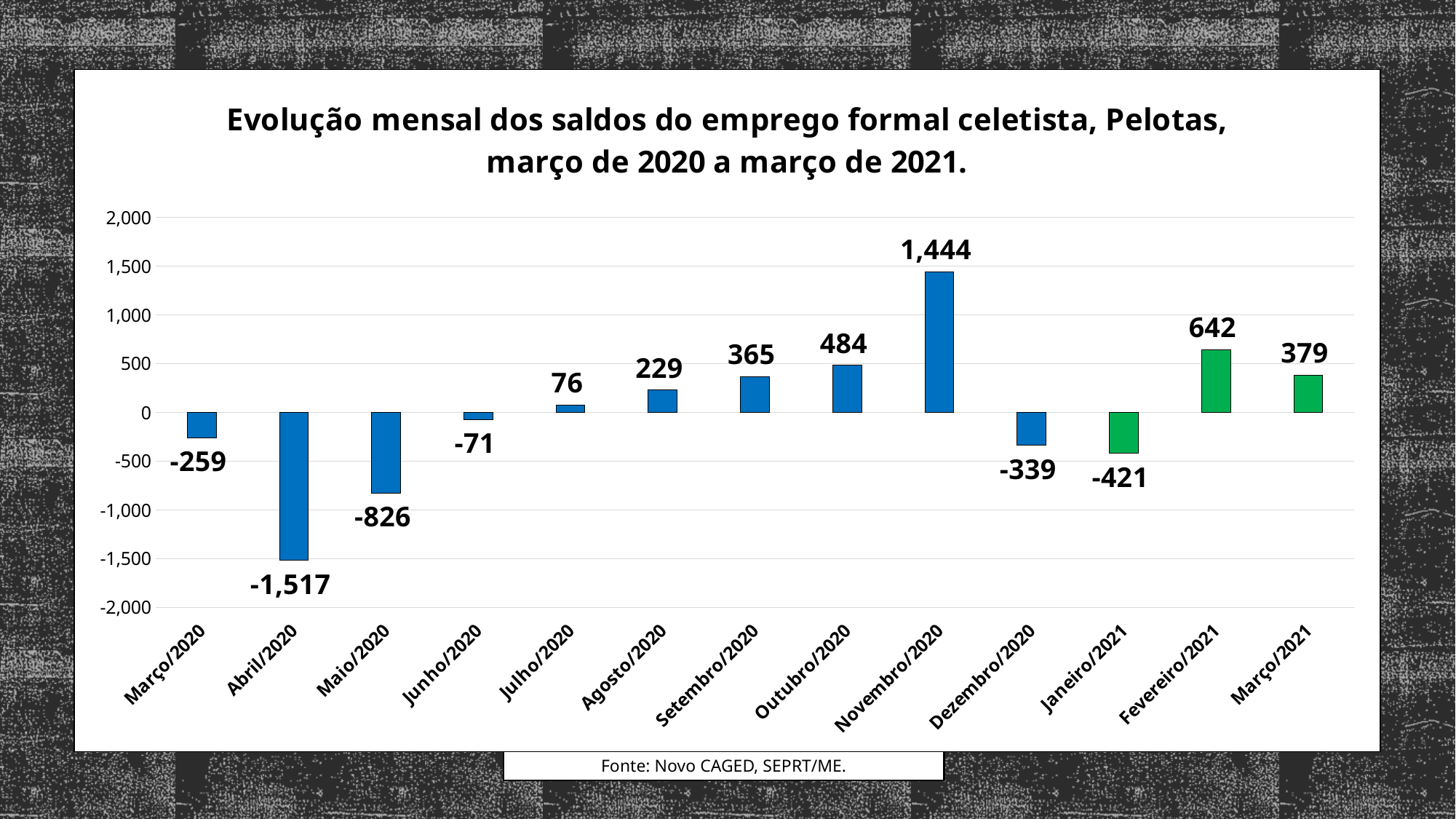
Do the values rise or fall from Julho/2020 to Novembro/2020? rise What is the source cited below the chart? Novo CAGED, SEPRT/ME. Which month has the highest value? Novembro/2020 Is the value for Maio/2020 greater or less than -500? less Which is larger, the value for Setembro/2020 or the value for Março/2021? Setembro/2020 What kind of chart is shown on the slide? bar chart What is the value for Fevereiro/2021? 642 How many months are shown on the x axis? 13 Which month has the lowest value? Abril/2020 What is the value for Novembro/2020? 1,444 What is the difference between the values for Novembro/2020 and Outubro/2020? 960 What is the value for Abril/2020? -1,517